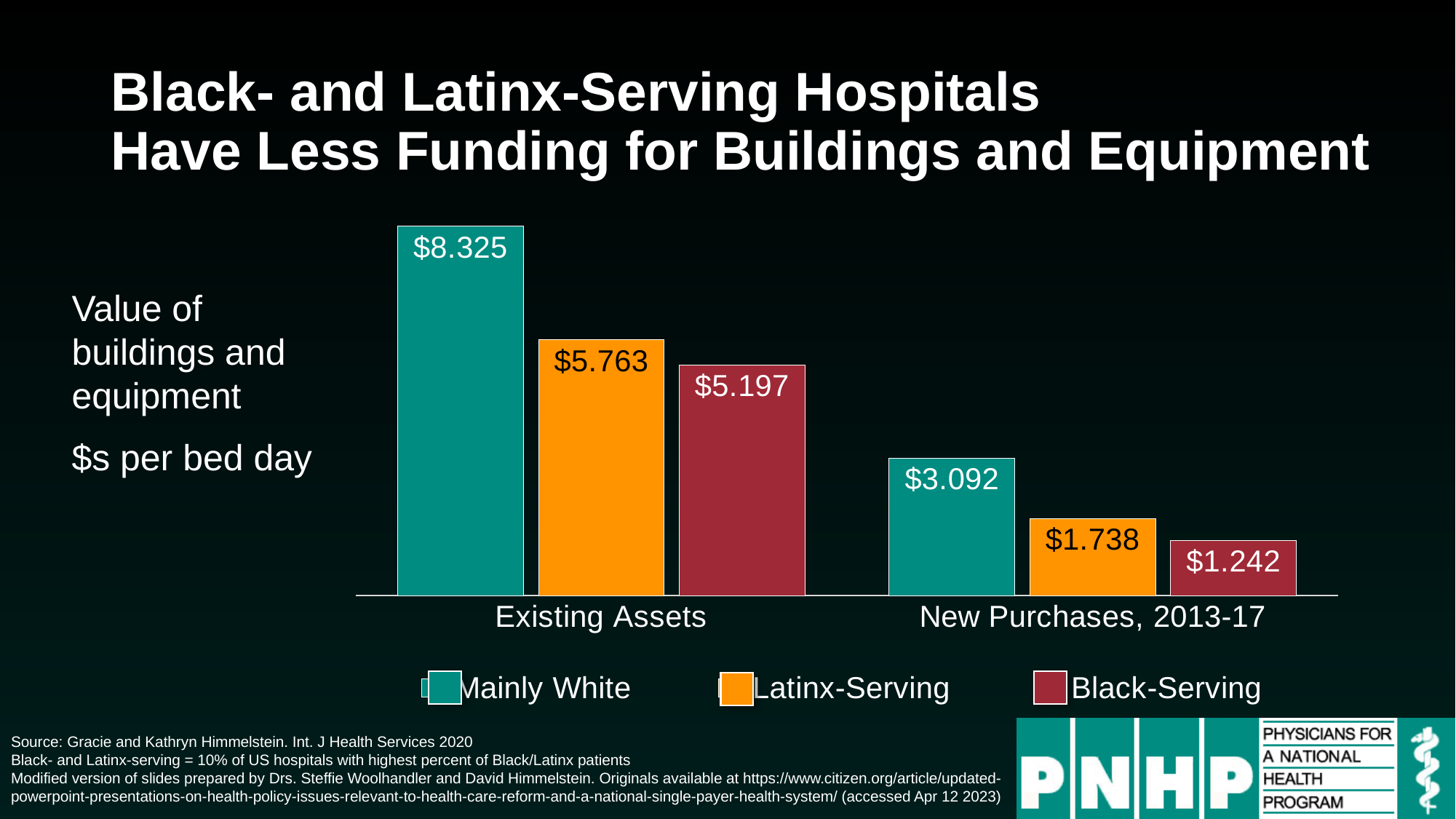
What is the value for Latinx-Serving hospitals under Existing Assets? $5.763 How many categories are shown on the x axis? 2 What is the value for Mainly White hospitals under Existing Assets? $8.325 What is the value for Black-Serving hospitals under New Purchases, 2013-17? $1.242 What colour represents Latinx-Serving hospitals in the chart? Orange Which is larger: the Latinx-Serving value under Existing Assets or the Mainly White value under New Purchases, 2013-17? Latinx-Serving under Existing Assets What is the difference between the Mainly White and Black-Serving values under Existing Assets? $3.128 How many series does the legend list? 3 What kind of chart is shown on the slide? Bar chart What is the difference between the Latinx-Serving and Black-Serving values under New Purchases, 2013-17? $0.496 Which hospital group has the highest value under New Purchases, 2013-17? Mainly White Which hospital group has the lowest value under Existing Assets? Black-Serving